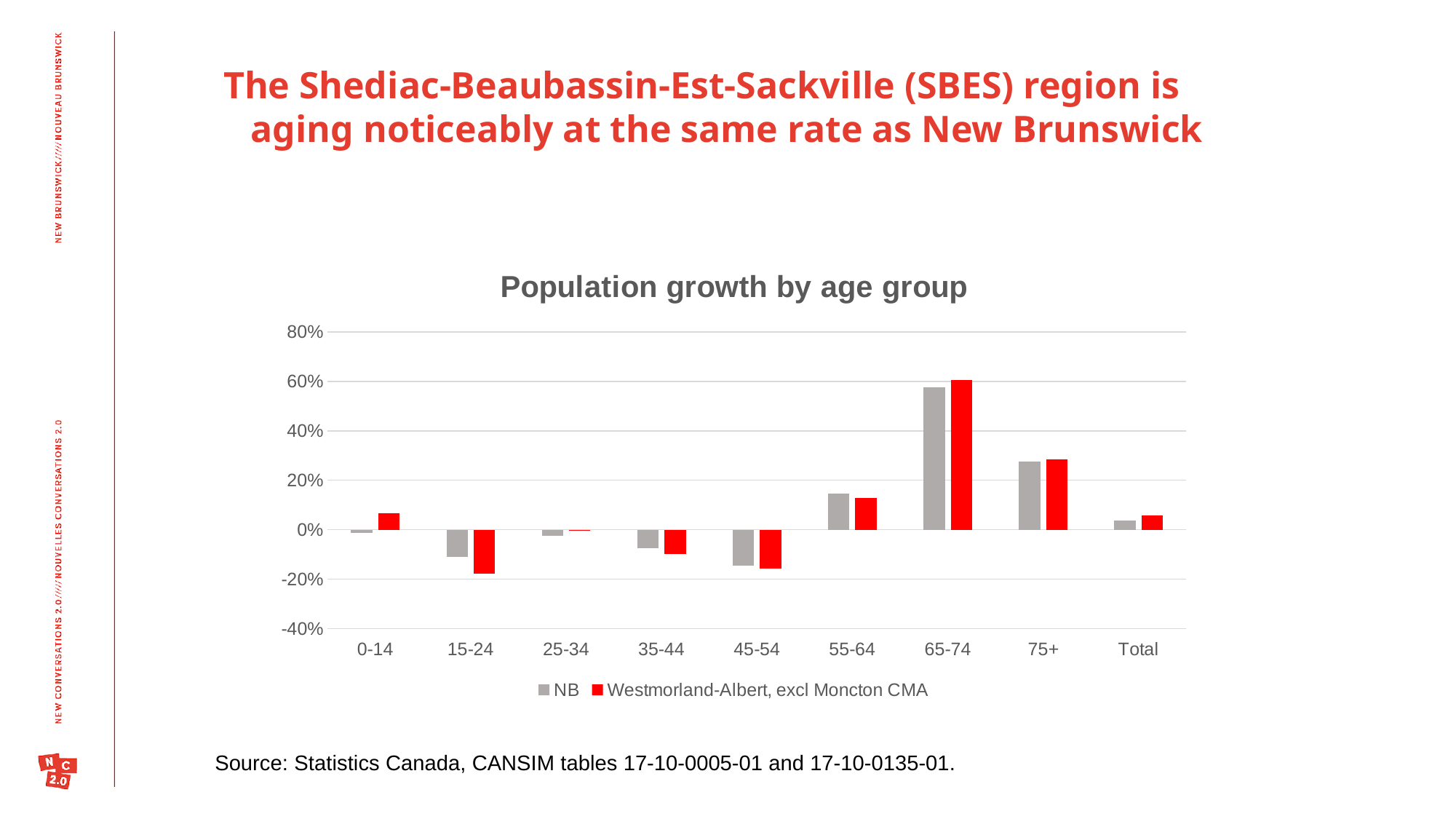
For the 0-14 age group, which series has the larger value, NB or Westmorland-Albert, excl Moncton CMA? Westmorland-Albert, excl Moncton CMA Which age group has the lowest population growth for Westmorland-Albert, excl Moncton CMA? 15-24 For the 15-24 age group, which series has the larger value, NB or Westmorland-Albert, excl Moncton CMA? NB What is the title of the chart? Population growth by age group What kind of chart is shown on the slide? bar chart Which age group has the highest population growth for NB? 65-74 How many age-group categories (including Total) are shown on the x axis? 9 Is the NB value for the 75+ age group greater or less than 20%? greater Is the NB value for the 65-74 age group greater or less than 40%? greater Is the Westmorland-Albert, excl Moncton CMA value for the 55-64 age group greater or less than 20%? less How many series does the legend list in the 'Population growth by age group' chart? 2